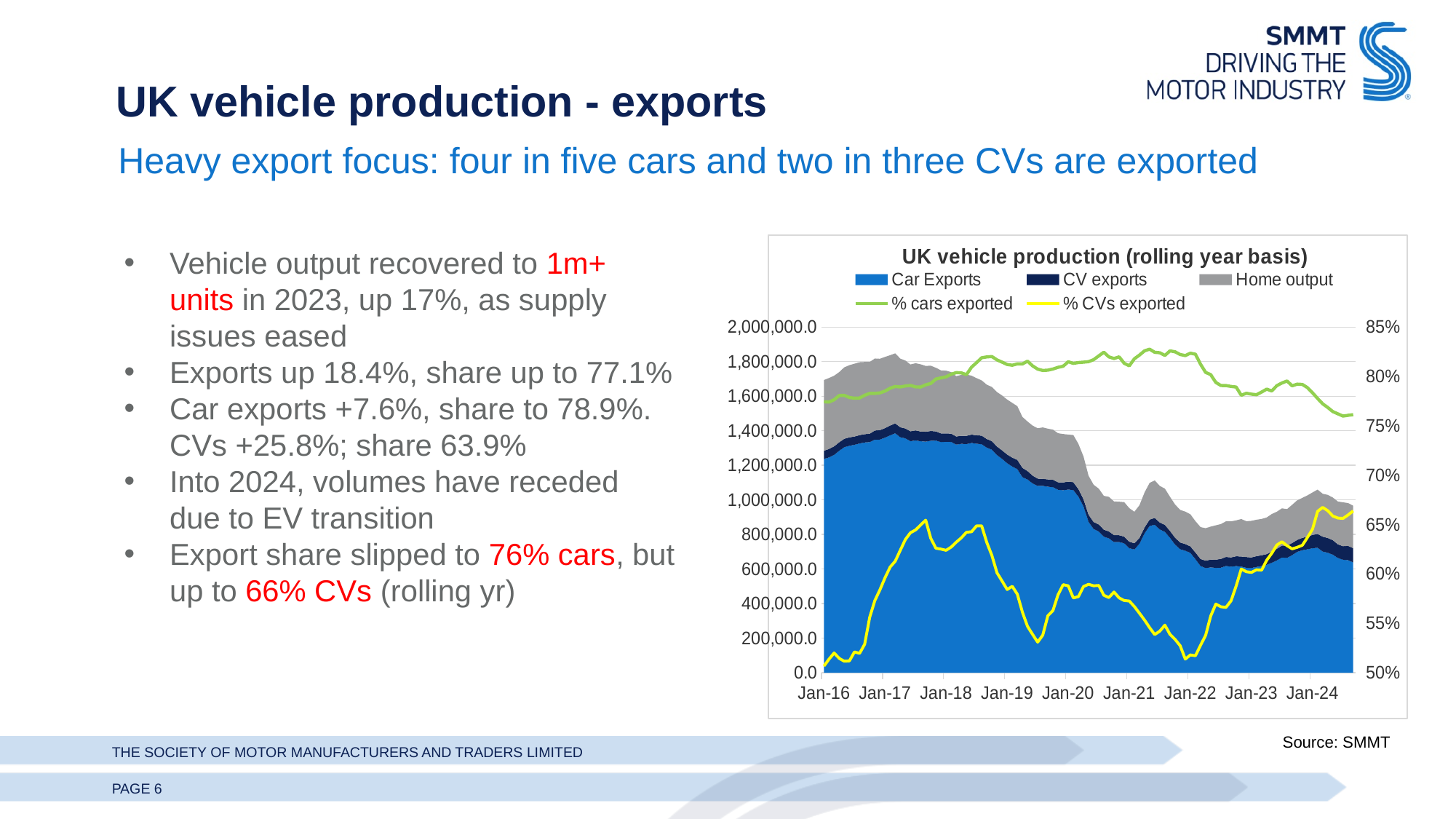
How many year labels are shown on the x axis of the chart? 9 Which series is shown in yellow in the chart? % CVs exported Does total vehicle production (top of the stacked area) rise or fall between Jan-17 and Jan-22? Fall Does the % cars exported line rise or fall between Jan-21 and Jan-24? Fall Does the % CVs exported line rise or fall between Jan-22 and Jan-24? Rise How many series does the chart legend list? 5 What kind of chart is shown on the slide? Stacked area chart with line series Is the % cars exported value at Jan-21 greater or less than 80%? greater Is total vehicle production (top of the stacked area) at Jan-17 greater or less than 1,600,000.0? greater Is the % CVs exported value at Jan-22 greater or less than 55%? less What is the title of the chart? UK vehicle production (rolling year basis)